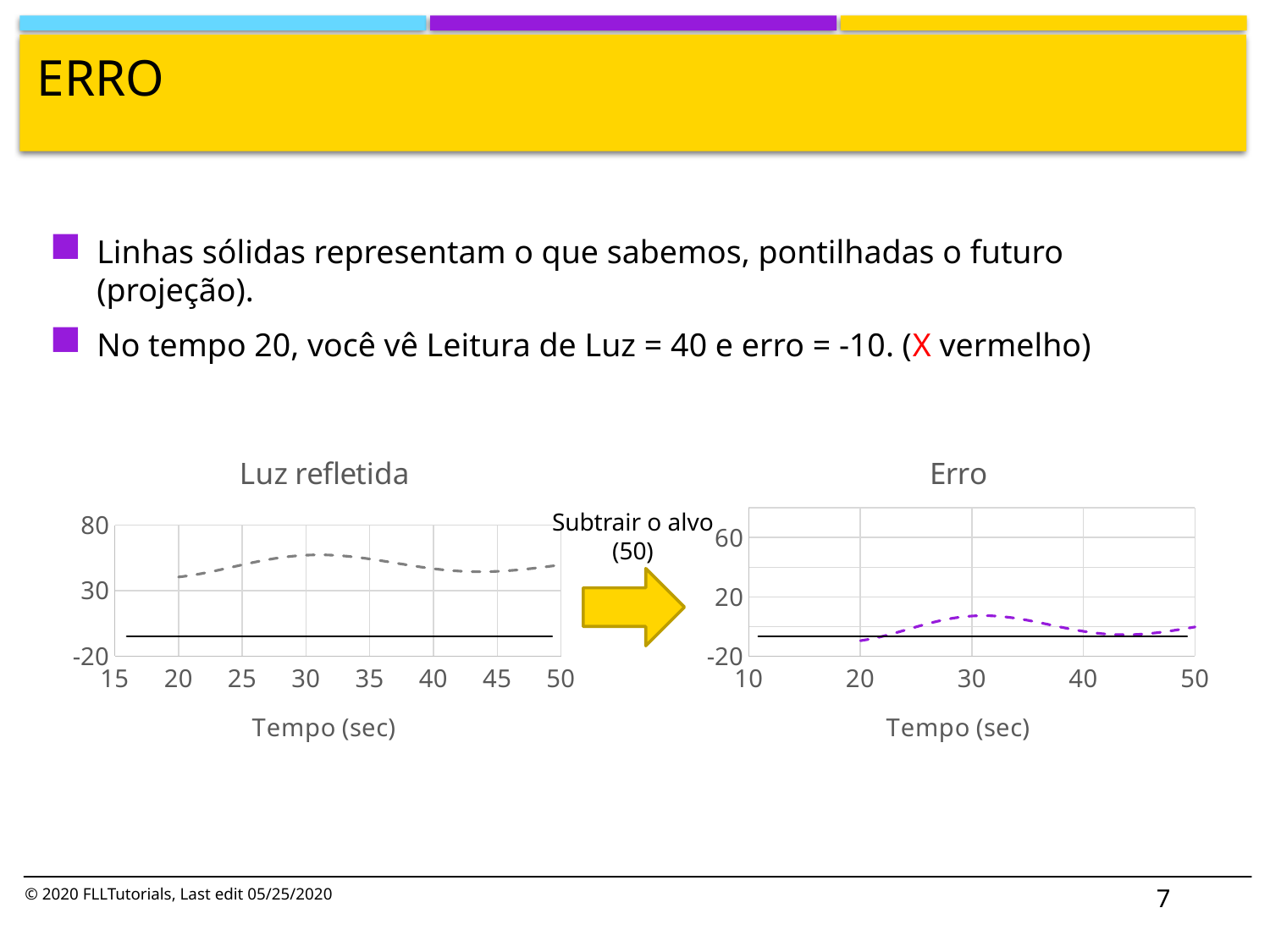
In the "Luz refletida" chart, does the dashed line rise or fall between time 20 and time 30? rise In the "Erro" chart, is the value at time 20 greater or less than 0? less In the "Erro" chart, does the dashed line rise or fall between time 30 and time 45? fall What is the x-axis label of the "Erro" chart? Tempo (sec) What kind of chart is the "Luz refletida" chart? line chart How many charts are shown on the slide? 2 In the "Luz refletida" chart, is the value at time 45 greater or less than 80? less What is the highest value shown on the y axis of the "Luz refletida" chart? 80 In the "Luz refletida" chart, is the value at time 30 greater or less than 30? greater What kind of chart is the "Erro" chart? line chart